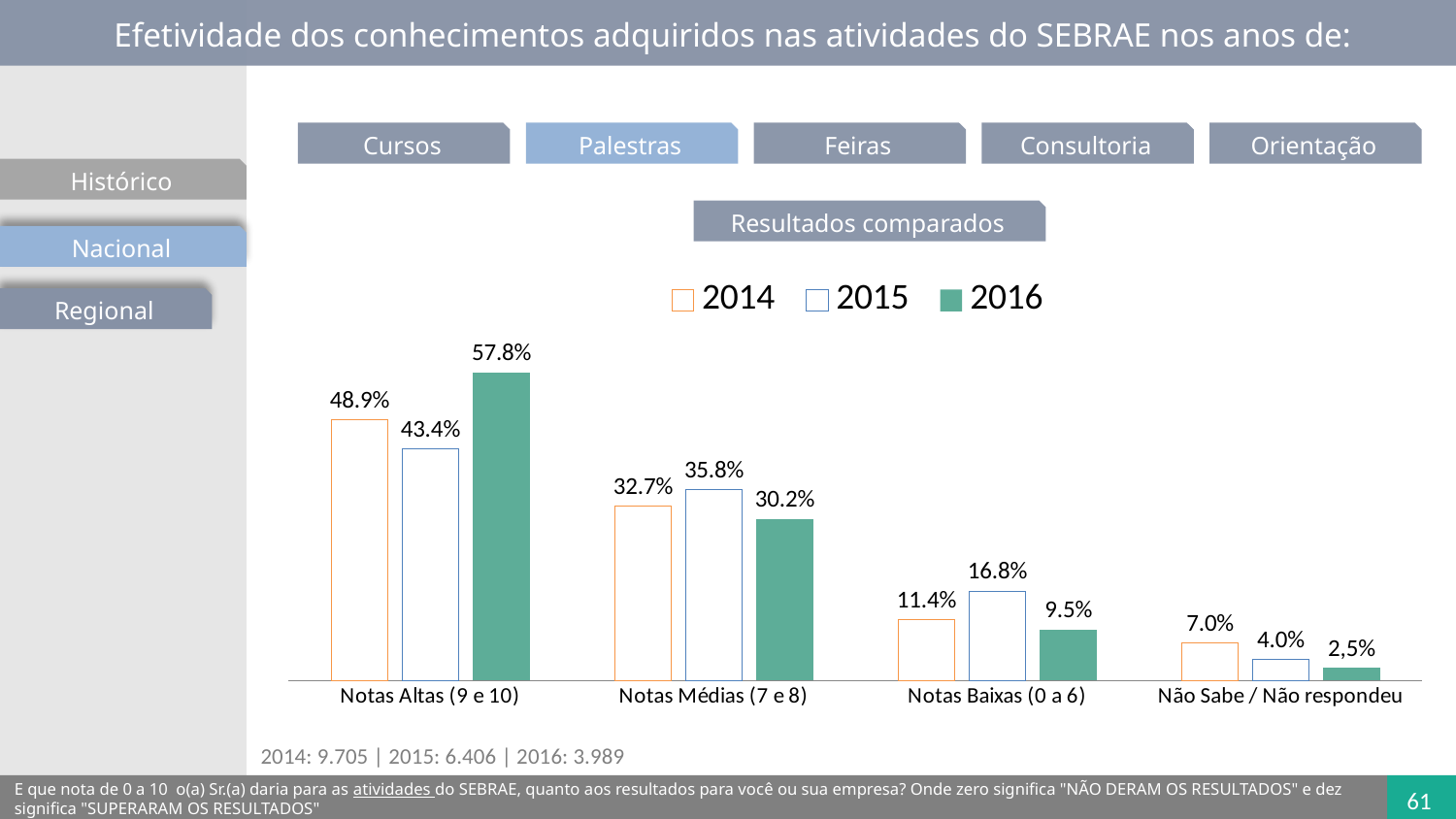
What is the value for 2016 in the Notas Altas (9 e 10) category? 57.8% In the Notas Médias (7 e 8) category, which is larger, the 2015 value or the 2016 value? 2015 What is the value for 2015 in the Notas Baixas (0 a 6) category? 16.8% How many series does the chart legend list? 3 What is the value for 2014 in the Notas Médias (7 e 8) category? 32.7% Which category has the lowest value for the 2014 series? Não Sabe / Não respondeu What kind of chart is shown on the slide? Bar chart What is the difference between the 2016 and 2014 values in the Notas Altas (9 e 10) category? 8.9% Which category has the highest value for the 2016 series? Notas Altas (9 e 10) How many categories are shown on the x axis of the chart? 4 Which series is shown with solid green bars in the chart? 2016 What is the value for 2016 in the Não Sabe / Não respondeu category? 2,5%